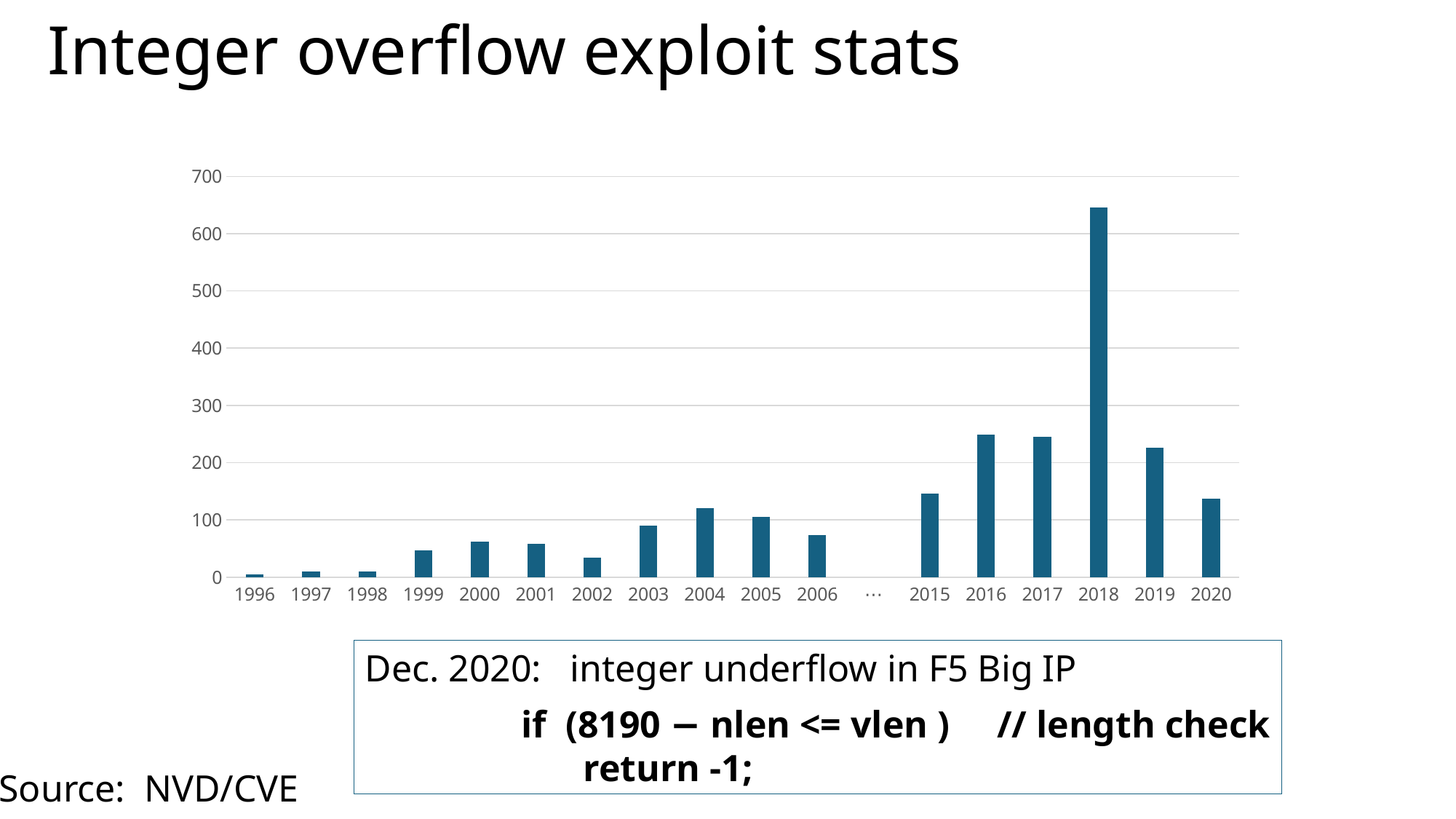
How many years are shown on the x axis of the chart? 17 Do the values rise or fall from 2018 to 2020? Fall Is the value for 2002 greater or less than 100? less What kind of chart is shown on the slide? Bar chart Which year has the larger value, 2018 or 2016? 2018 Which year has the lowest bar in the chart? 1996 Is the value for 2020 greater or less than 200? less Which year has the larger value, 2019 or 2020? 2019 Which year has the highest bar in the chart? 2018 Is the value for 2018 greater or less than 600? greater